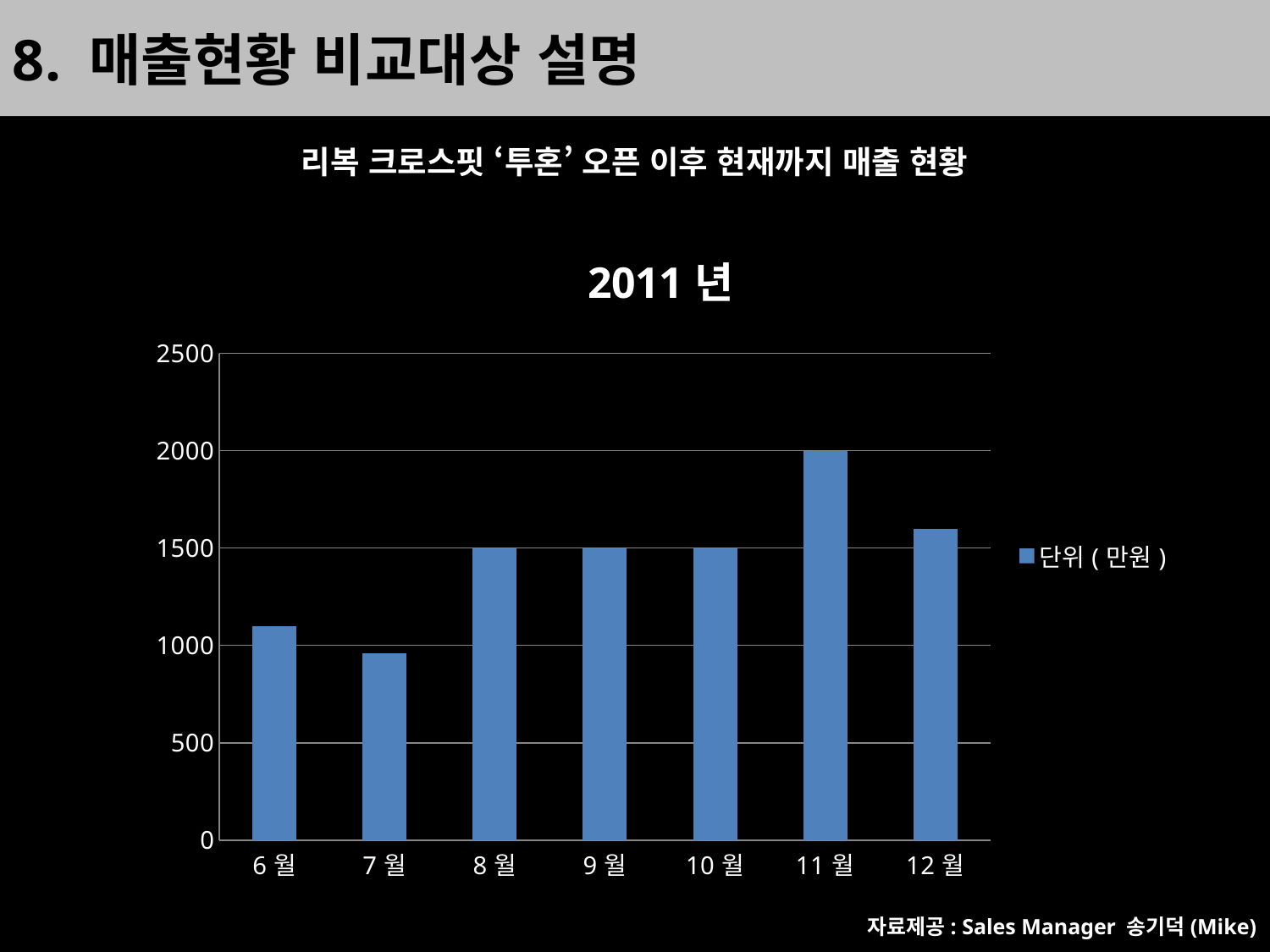
Which month has the lowest value? 7 월 Which is larger, the value for 6 월 or the value for 7 월? 6 월 What is the difference between the values for 11 월 and 9 월? 500 Is the value for 7 월 greater or less than 1000? less Is the value for 12 월 greater or less than 1500? greater How many series does the chart legend list? 1 What is the value for 8 월? 1500 What kind of chart is shown on the slide? bar chart What is the title of the chart? 2011 년 What is the value for 11 월? 2000 Which month has the highest value? 11 월 How many months are shown on the x axis of the chart? 7